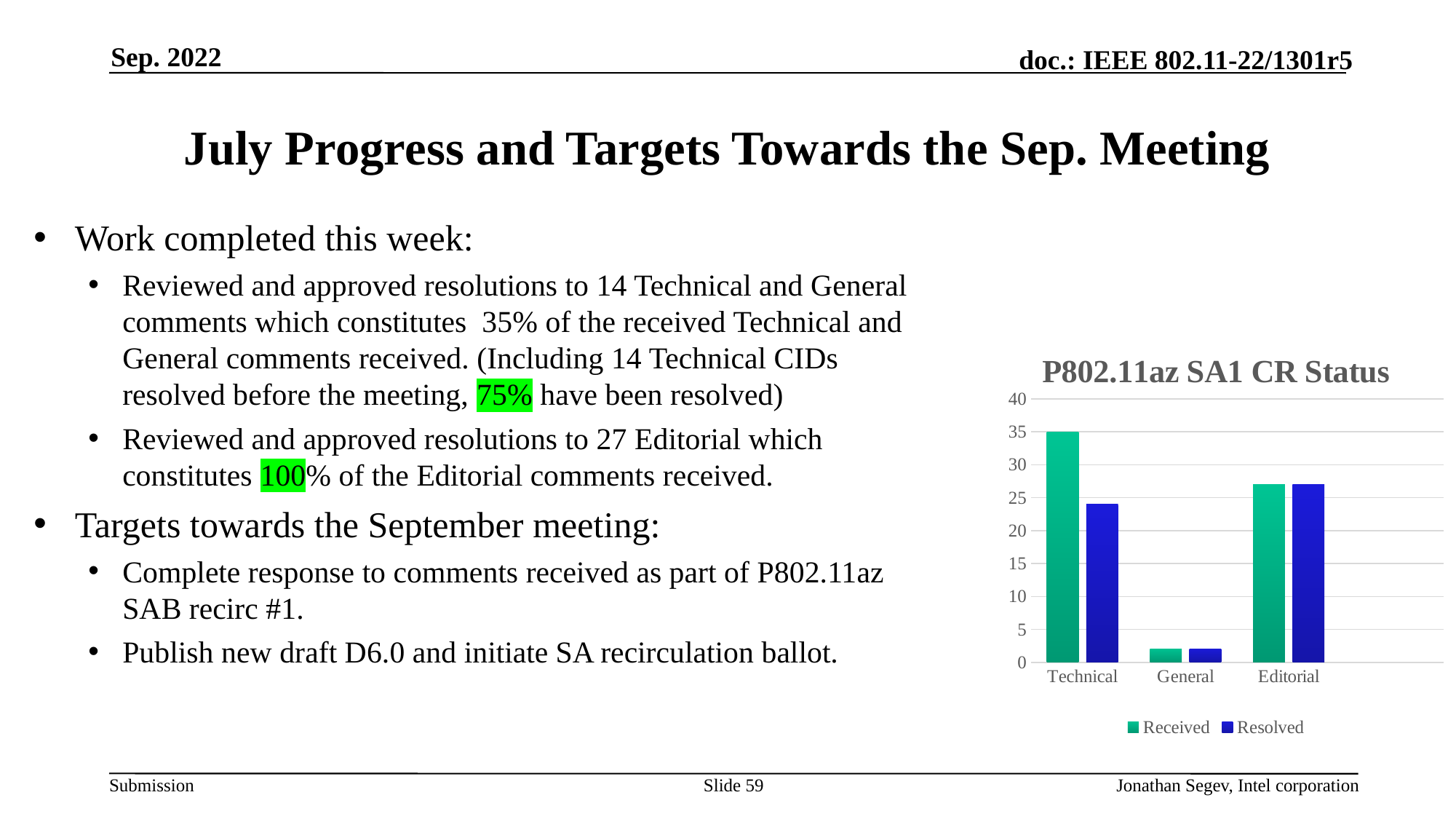
What is the title of the chart? P802.11az SA1 CR Status Is the Resolved value for Technical greater or less than 20? greater For the Technical category, which is larger: Received or Resolved? Received What type of chart is shown on the slide? bar chart Is the Received value for General greater or less than 5? less Is the Received value for Technical greater or less than 30? greater How many series does the chart's legend list? 2 Which series is shown in dark blue in the chart? Resolved How many categories are shown on the x axis of the chart? 3 Which category has the highest Received value? Technical Which category has the lowest Resolved value? General Which category has the lowest Received value? General